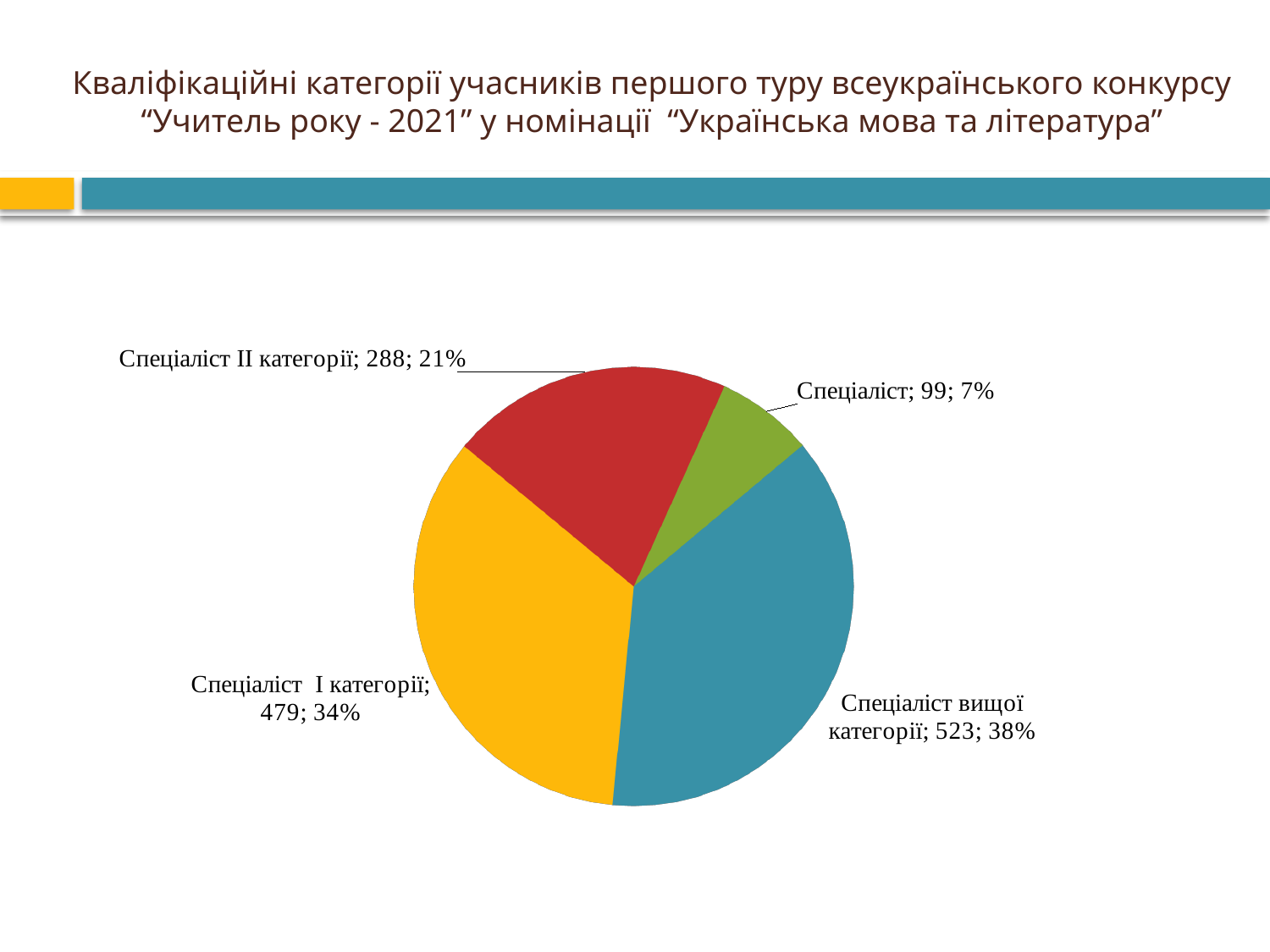
What share of the pie does Спеціаліст II категорії represent? 21% What is the value for Спеціаліст I категорії? 479 What is the value for Спеціаліст? 99 What is the value for Спеціаліст вищої категорії? 523 What share of the pie does Спеціаліст I категорії represent? 34% What is the difference between the values for Спеціаліст вищої категорії and Спеціаліст I категорії? 44 What is the value for Спеціаліст II категорії? 288 What kind of chart is shown on the slide? pie chart Which category has the largest slice? Спеціаліст вищої категорії Which is larger, the value for Спеціаліст II категорії or the value for Спеціаліст? Спеціаліст II категорії Which category has the smallest slice? Спеціаліст How many slices does the pie chart have? 4